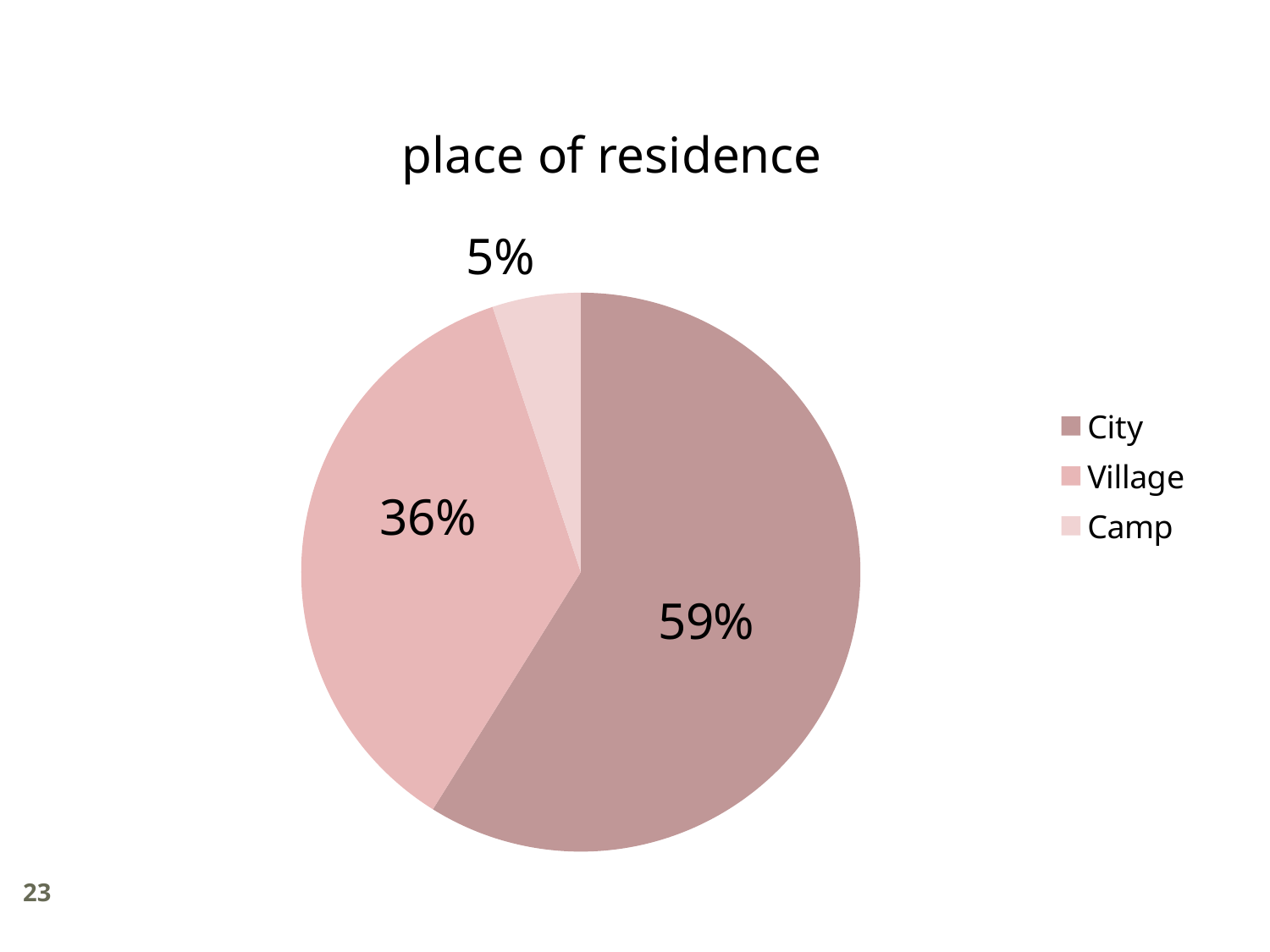
Which categories are listed in the legend? City, Village, Camp How many categories does the pie chart show? 3 Which place of residence has the smallest share? Camp What is the difference in percentage points between the City and Village shares? 23 What kind of chart is shown on the slide? Pie chart What is the title of the chart? place of residence Which place of residence has the largest share? City What share of the pie does Village account for? 36% What is the difference in percentage points between the Village and Camp shares? 31 Which is larger, the share for Village or the share for Camp? Village What share of the pie does Camp account for? 5% What share of the pie does City account for? 59%